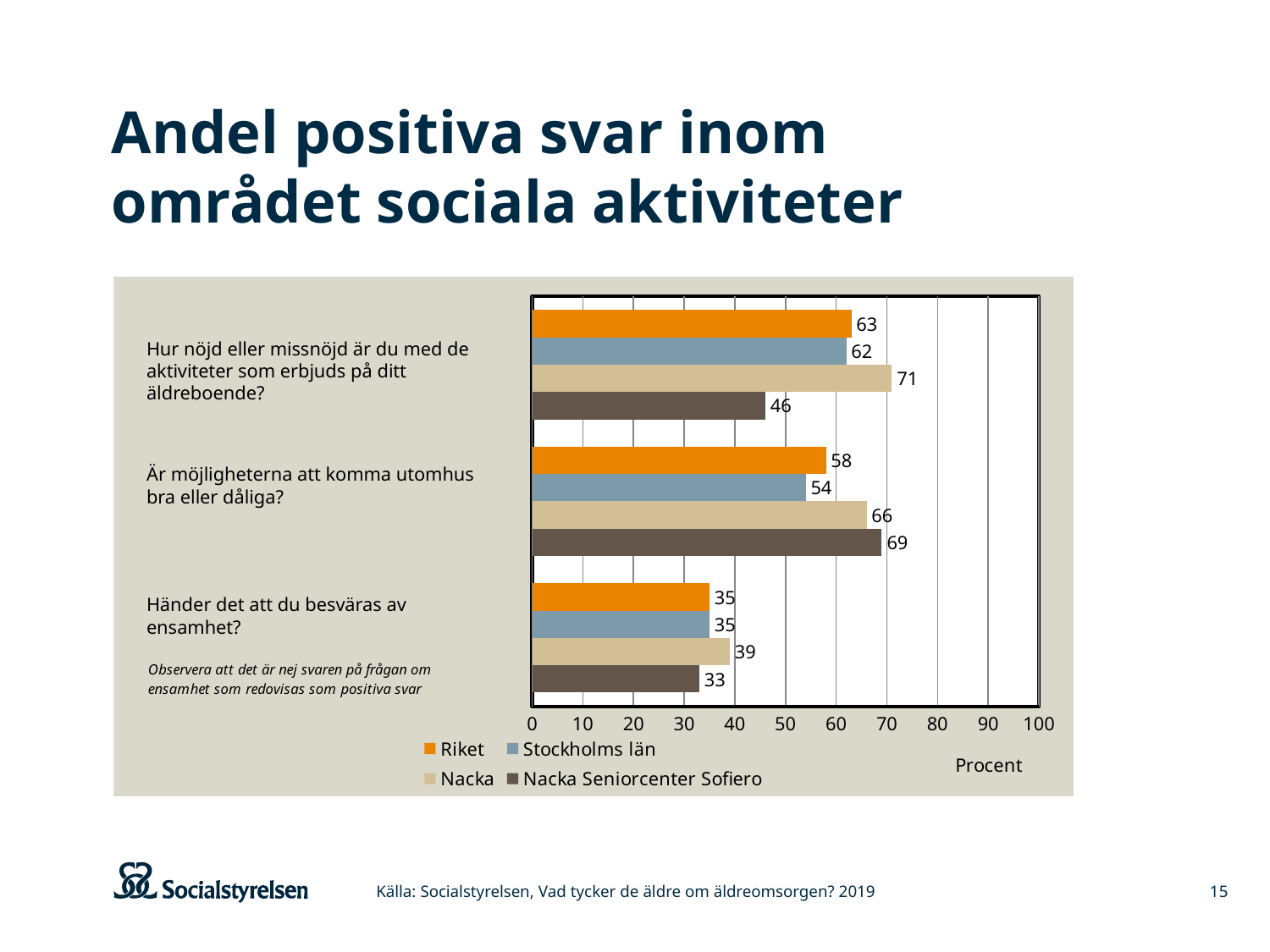
What is the difference between Nacka and Nacka Seniorcenter Sofiero on the question "Hur nöjd eller missnöjd är du med de aktiviteter som erbjuds på ditt äldreboende?"? 25 Which is larger on the question "Är möjligheterna att komma utomhus bra eller dåliga?": Riket or Stockholms län? Riket Which series has the lowest value on the question "Hur nöjd eller missnöjd är du med de aktiviteter som erbjuds på ditt äldreboende?"? Nacka Seniorcenter Sofiero What is the value for Nacka Seniorcenter Sofiero on the question "Är möjligheterna att komma utomhus bra eller dåliga?"? 69 How many question categories are shown on the chart? 3 Which series has the highest value on the question "Är möjligheterna att komma utomhus bra eller dåliga?"? Nacka Seniorcenter Sofiero What is the value for Riket on the question "Händer det att du besväras av ensamhet?"? 35 Is the value for Nacka on the question "Händer det att du besväras av ensamhet?" greater or less than 50? less What is the label on the horizontal axis of the chart? Procent What is the value for Nacka on the question "Hur nöjd eller missnöjd är du med de aktiviteter som erbjuds på ditt äldreboende?"? 71 What kind of chart is shown on the slide? Bar chart How many series does the legend list? 4